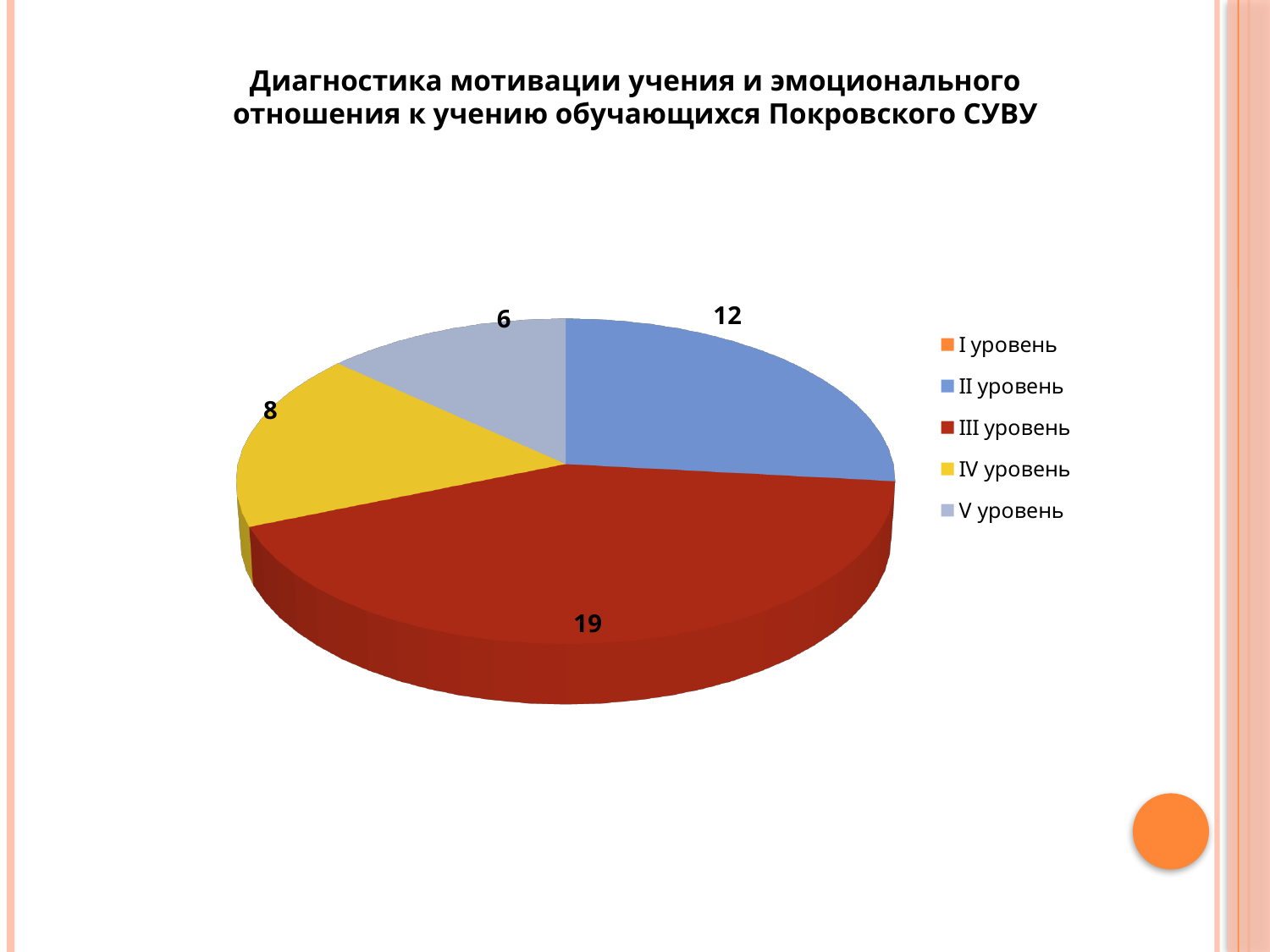
Which legend entry is shown in yellow? IV уровень What is the difference between the values for III уровень and II уровень? 7 Which labelled slice has the smallest value? V уровень What kind of chart is shown on the slide? Pie chart What value is shown for V уровень? 6 What value is shown for IV уровень? 8 What colour is the slice for III уровень? Red Which category has the largest slice of the pie? III уровень How many entries does the legend list? 5 What value is shown for II уровень? 12 What value is shown for III уровень? 19 Which is larger, the value for IV уровень or the value for V уровень? IV уровень